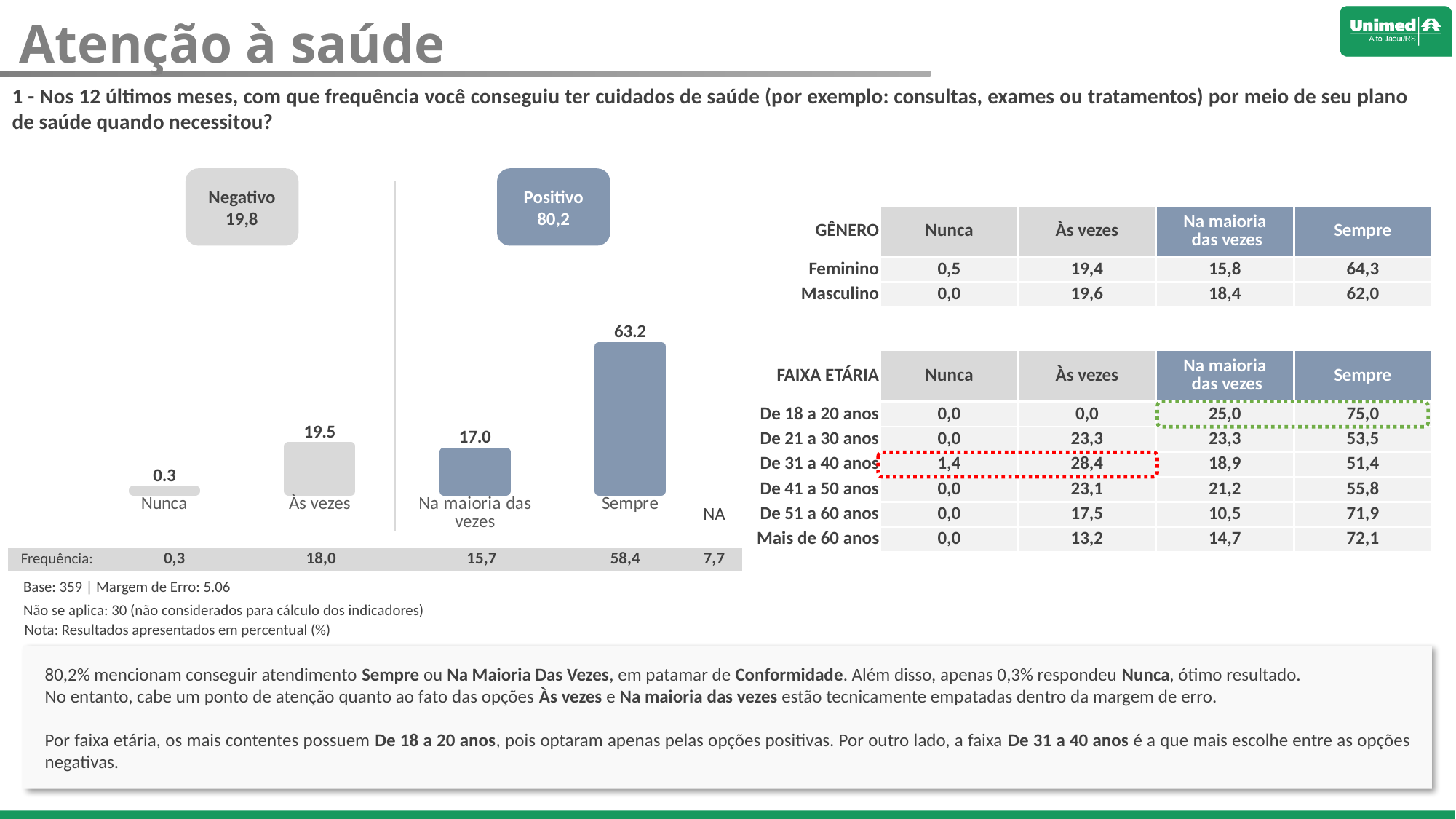
What value is shown in the Positivo box above the chart? 80,2 What is the difference between the values for Sempre and Na maioria das vezes? 46.2 What is the difference between the values for Às vezes and Nunca? 19.2 What is the value of the bar for Sempre? 63.2 What is the value of the bar for Às vezes? 19.5 Which category has the lowest bar? Nunca Which is larger, the value for Às vezes or the value for Na maioria das vezes? Às vezes What is the value of the bar for Nunca? 0.3 Which category has the highest bar? Sempre What is the value of the bar for Na maioria das vezes? 17.0 What type of chart is shown on the slide? bar chart How many bars are plotted in the chart? 4